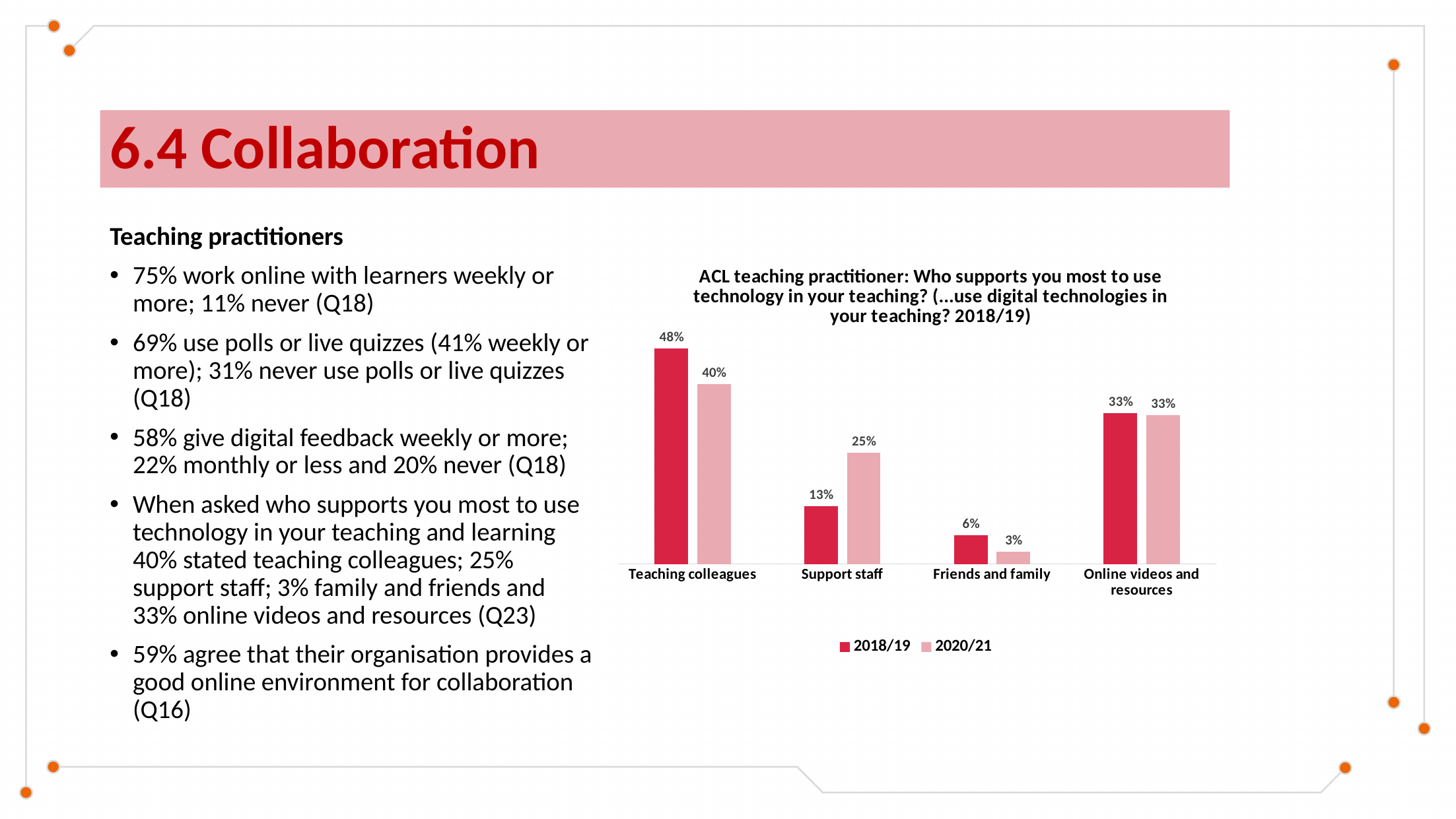
What is the difference between the 2018/19 and 2020/21 values for Teaching colleagues? 8% Which series is shown in the darker red colour? 2018/19 Which category has the highest 2018/19 value? Teaching colleagues Which is larger for Support staff, the 2018/19 value or the 2020/21 value? 2020/21 What kind of chart is shown on the slide? Bar chart How many series does the legend list? 2 Which category has the lowest 2020/21 value? Friends and family What is the difference between the 2020/21 and 2018/19 values for Support staff? 12% What is the 2020/21 value for Friends and family? 3% What is the 2020/21 value for Support staff? 25% What is the 2018/19 value for Teaching colleagues? 48% How many categories are shown on the x axis? 4